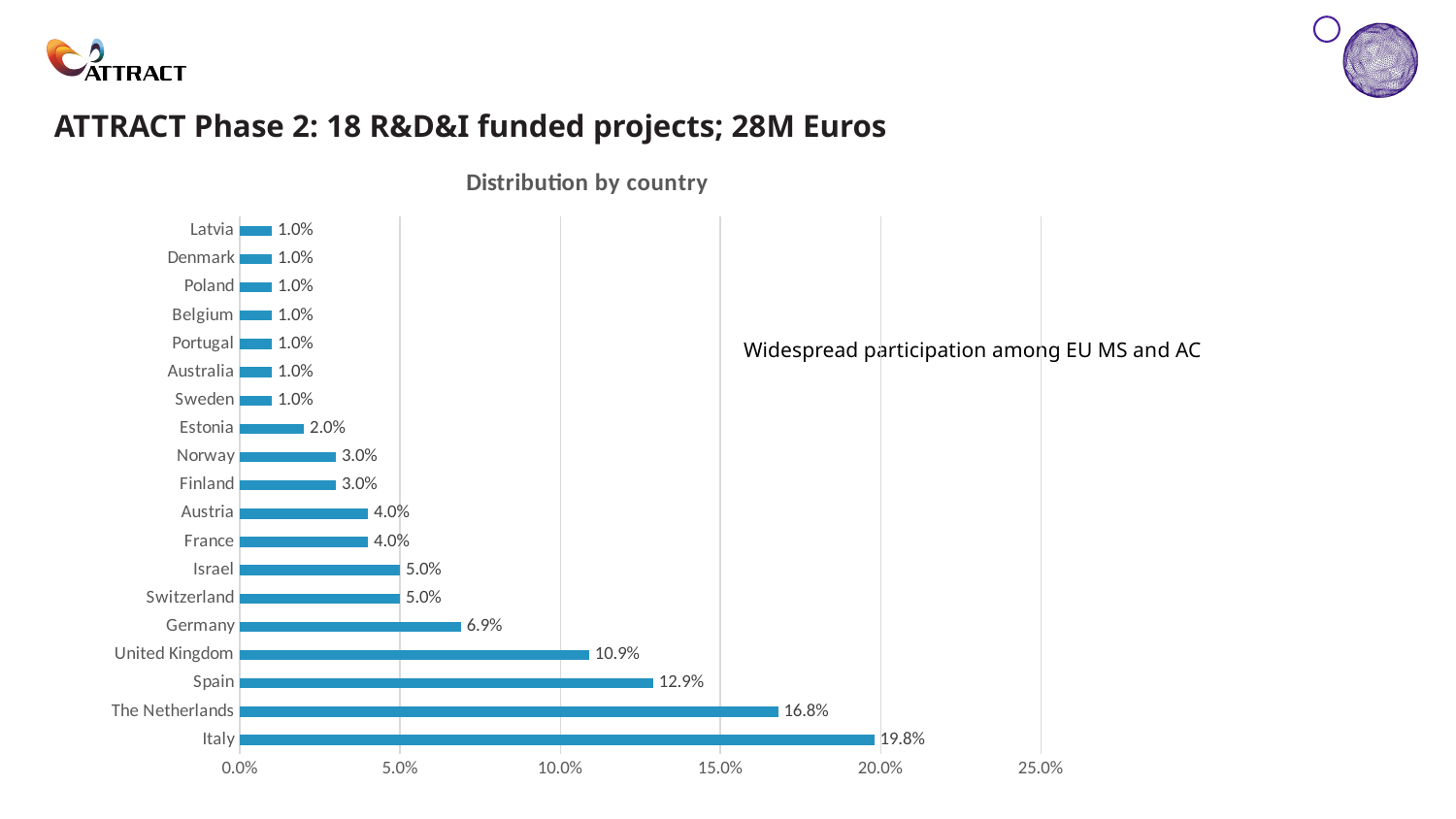
Which country has the highest value in the chart? Italy Is the value for The Netherlands greater or less than 15.0%? greater What is the value for Germany? 6.9% What is the difference between the values for Spain and the United Kingdom? 2.0% What is the value for Italy in the Distribution by country chart? 19.8% What is the difference between the values for Italy and The Netherlands? 3.0% What kind of chart is shown on the slide? Bar chart What is the value for Estonia? 2.0% Which is larger, the value for Spain or the value for Germany? Spain What is the value for the United Kingdom? 10.9% What is the title of the chart? Distribution by country How many countries are shown in the chart? 19